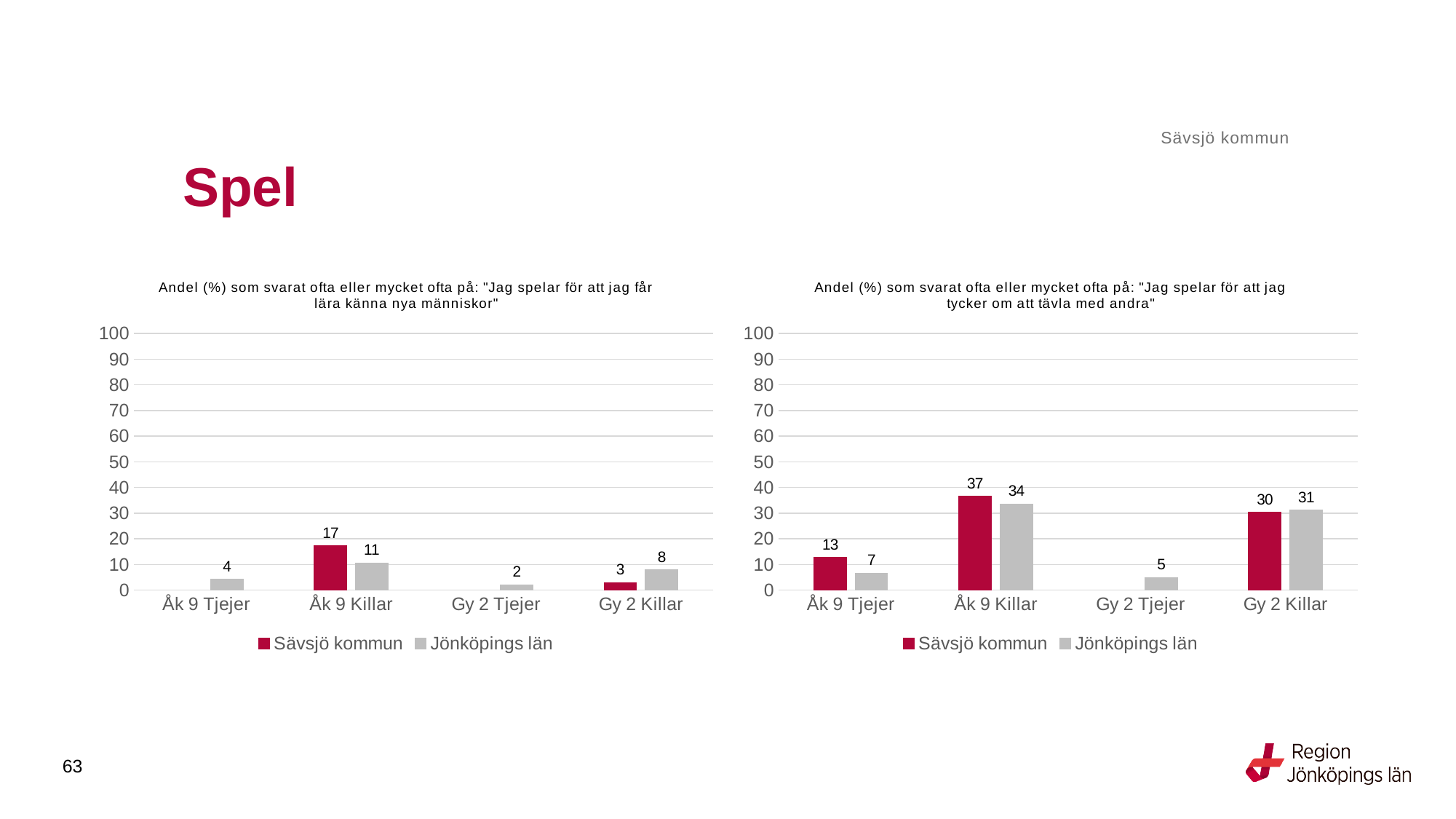
How many categories are shown on the x axis of the right chart? 4 In the right chart, which category has the highest value for Sävsjö kommun? Åk 9 Killar In the left chart, what is the value for Sävsjö kommun for Åk 9 Killar? 17 In the left chart, what is the value for Jönköpings län for Gy 2 Killar? 8 In the left chart, which category has the lowest value for Jönköpings län? Gy 2 Tjejer In the right chart, what is the value for Jönköpings län for Gy 2 Tjejer? 5 In the right chart, is the value for Jönköpings län for Åk 9 Killar greater or less than 30? greater In the left chart, which is larger for Gy 2 Killar: Sävsjö kommun or Jönköpings län? Jönköpings län In the right chart, what is the value for Sävsjö kommun for Åk 9 Tjejer? 13 How many series does the legend of the left chart list? 2 In the right chart, what is the difference between Sävsjö kommun and Jönköpings län for Åk 9 Killar? 3 What kind of chart is the left chart? Bar chart